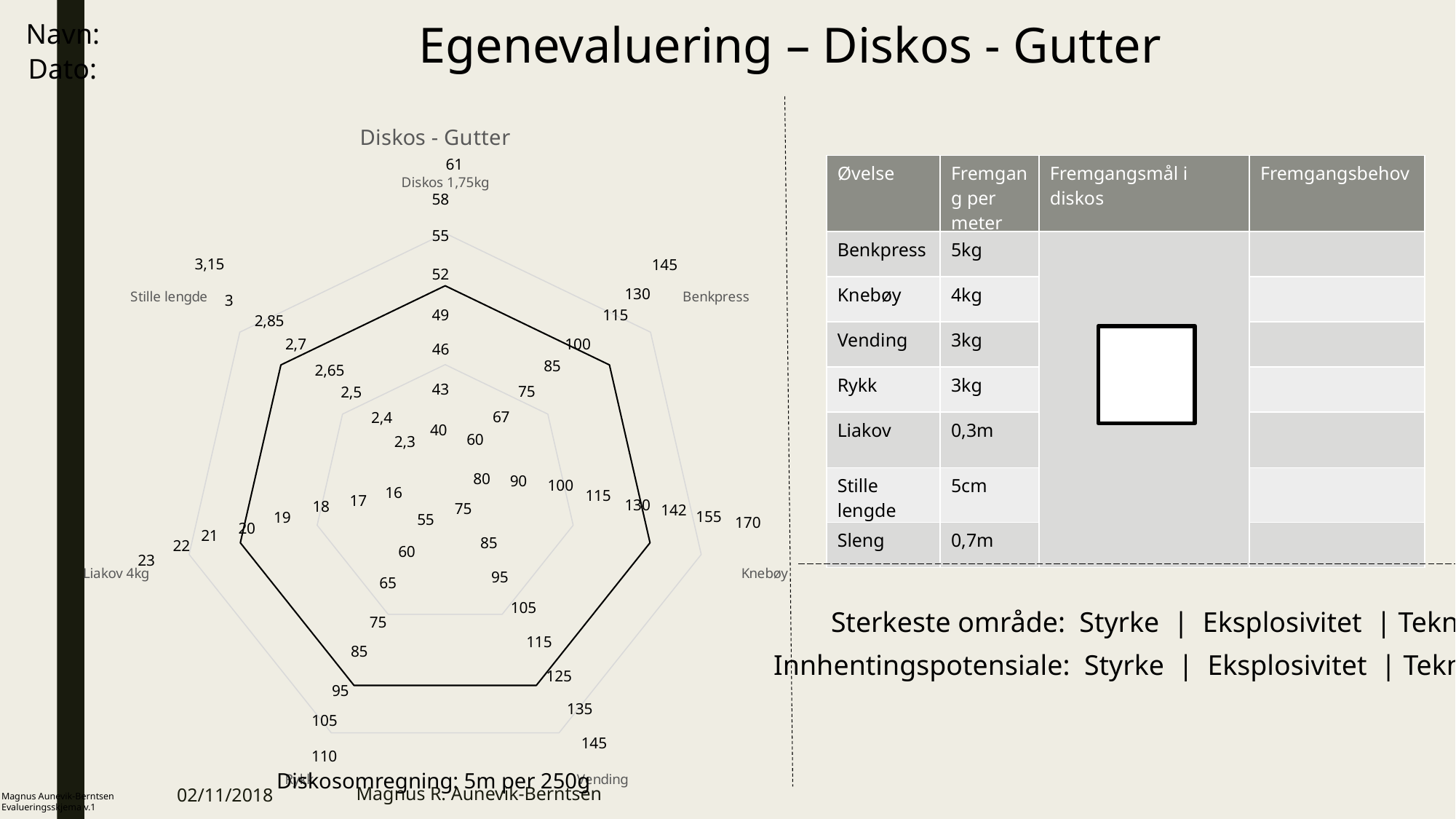
What is the highest tick value shown on the Knebøy axis? 170 How many axes (categories) does the radar chart have? 7 What is the title of the chart? Diskos - Gutter What kind of chart is shown on the slide? Radar chart Is the plotted value on the Rykk axis greater or less than 105? less Is the plotted value on the Knebøy axis greater or less than 115? greater Is the plotted value on the Benkpress axis greater or less than 115? less